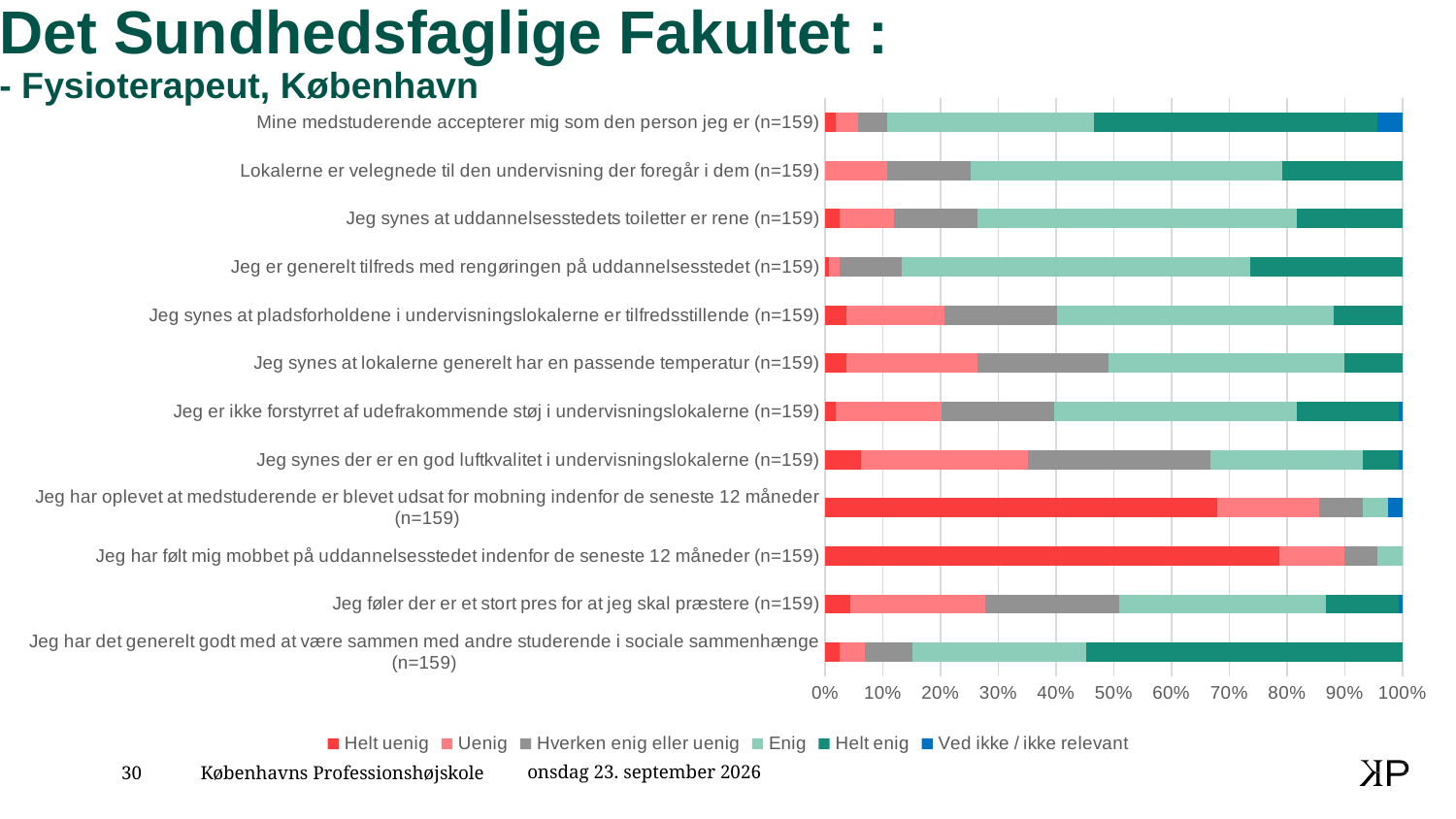
Is the 'Helt enig' share for 'Jeg har det generelt godt med at være sammen med andre studerende i sociale sammenhænge' greater or less than 50%? greater How many series does the legend list? 6 What kind of chart is shown on the slide? Stacked bar chart Which has the larger 'Helt enig' share: 'Jeg har det generelt godt med at være sammen med andre studerende i sociale sammenhænge' or 'Jeg føler der er et stort pres for at jeg skal præstere'? Jeg har det generelt godt med at være sammen med andre studerende i sociale sammenhænge Which statement has the largest 'Helt uenig' share? Jeg har følt mig mobbet på uddannelsesstedet indenfor de seneste 12 måneder How many statements (categories) are plotted in the chart? 12 Is the 'Helt uenig' share for 'Jeg synes der er en god luftkvalitet i undervisningslokalerne' greater or less than 10%? less Which response category is shown in dark blue in the legend? Ved ikke / ikke relevant Is the 'Helt uenig' share for 'Jeg har følt mig mobbet på uddannelsesstedet indenfor de seneste 12 måneder' greater or less than 70%? greater Which has the larger 'Helt uenig' share: 'Jeg har følt mig mobbet på uddannelsesstedet indenfor de seneste 12 måneder' or 'Jeg har oplevet at medstuderende er blevet udsat for mobning indenfor de seneste 12 måneder'? Jeg har følt mig mobbet på uddannelsesstedet indenfor de seneste 12 måneder What sample size (n) is shown for each statement in the chart? 159